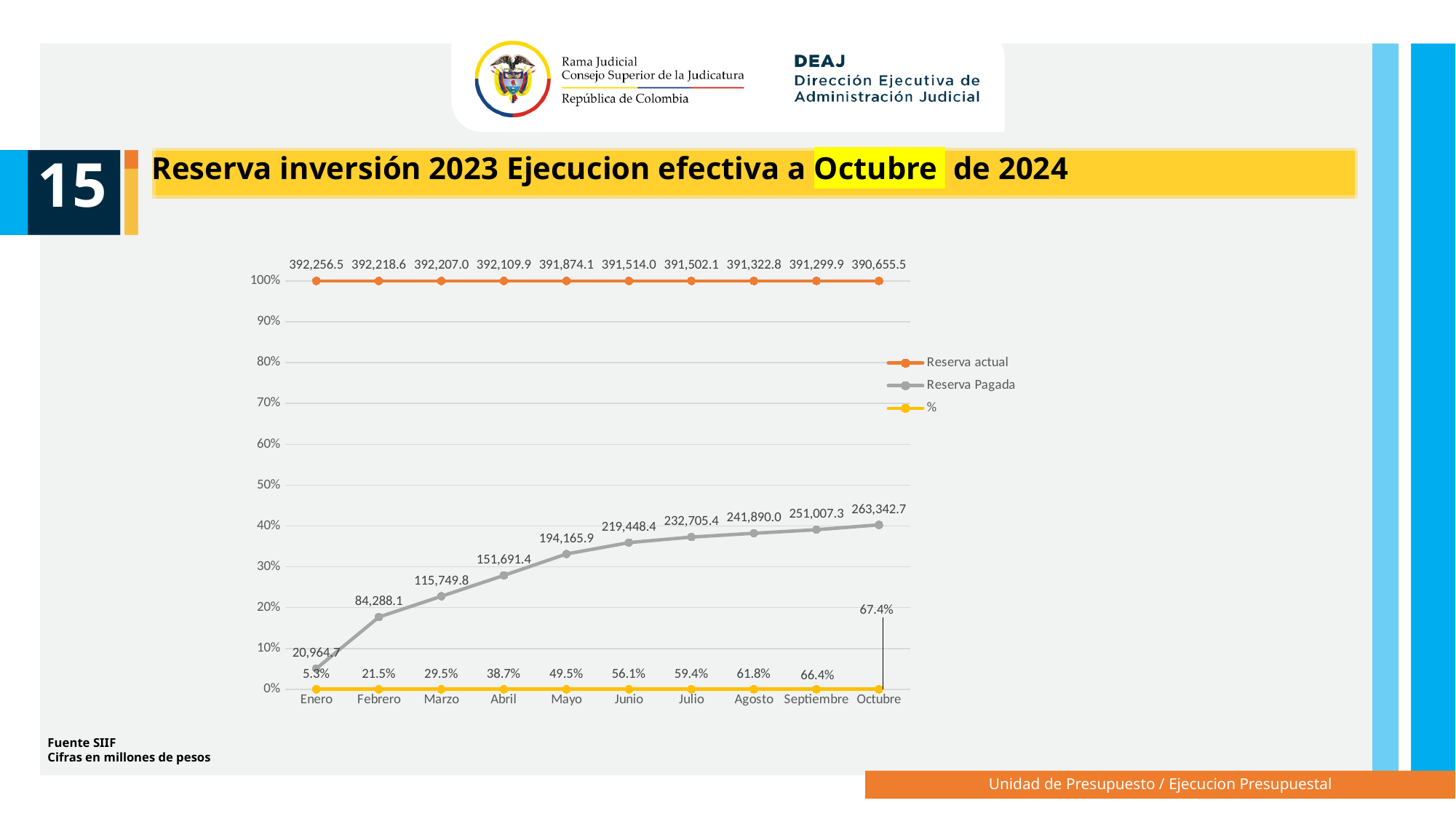
Does the Reserva Pagada series rise or fall from Enero to Octubre? Rise What is the Reserva actual value for Enero? 392,256.5 In which month is the Reserva actual value highest? Enero What percentage (%) is shown for Mayo? 49.5% In which month is the Reserva Pagada value lowest? Enero Which is larger, the Reserva Pagada value for Junio or for Marzo? Junio How many months are shown on the x axis? 10 What is the Reserva Pagada value for Abril? 151,691.4 What kind of chart is shown on the slide? Line chart What is the difference between the Reserva Pagada values for Octubre and Septiembre? 12,335.4 How many series does the legend list? 3 What is the Reserva Pagada value for Octubre? 263,342.7